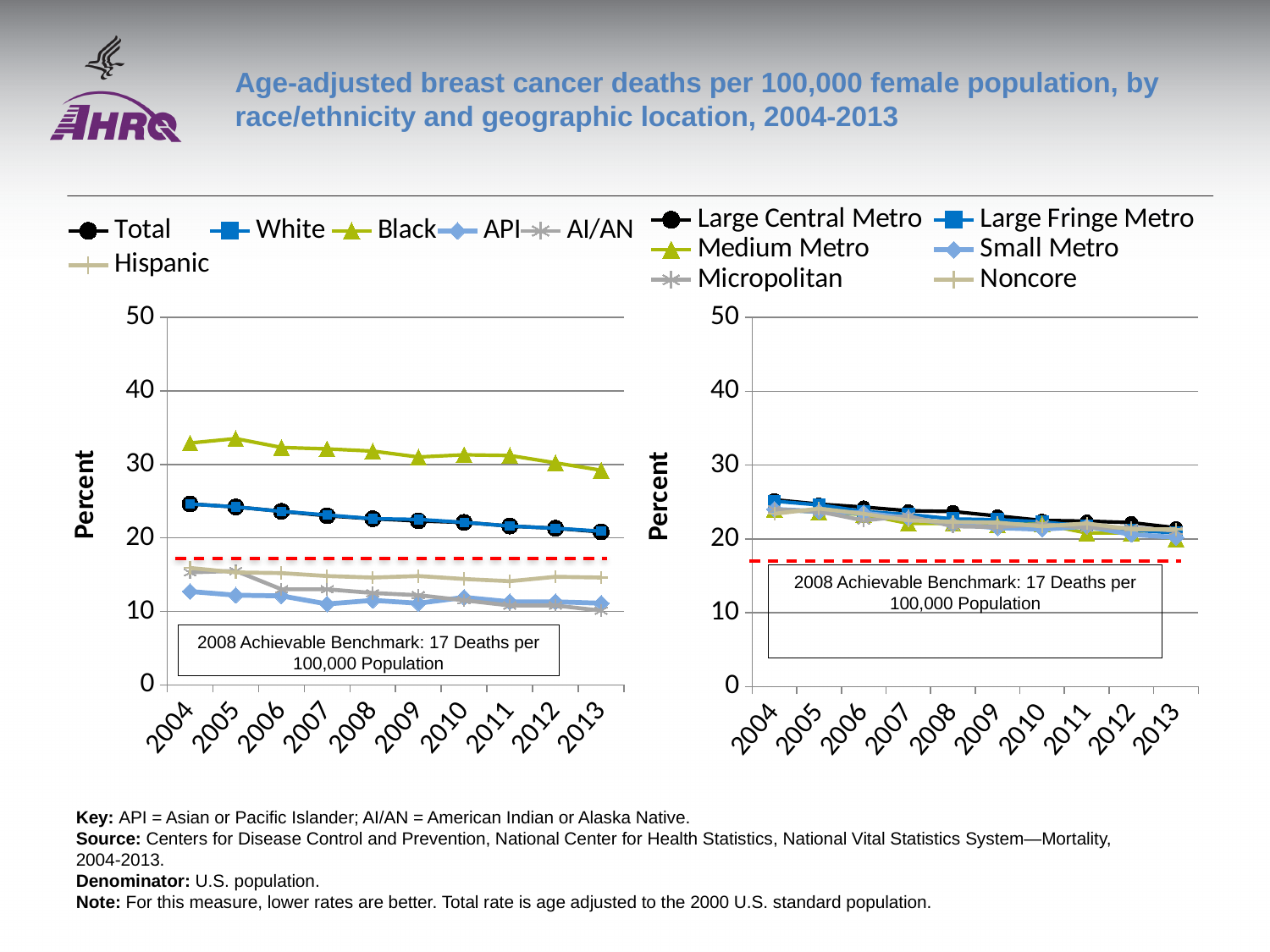
What is the 2008 Achievable Benchmark shown on the charts? 17 Deaths per 100,000 Population In the left chart (by race/ethnicity), is the value for Black in 2004 greater or less than 30? greater How many years are shown on the x axis of the left chart (by race/ethnicity)? 10 In the left chart (by race/ethnicity), is the value for API in 2004 greater or less than 20? less How many series does the legend of the left chart (by race/ethnicity) list? 6 What kind of chart is the left chart (by race/ethnicity)? line chart In the left chart (by race/ethnicity), which is larger in 2013, the value for Black or the value for Total? Black How many series does the legend of the right chart (by geographic location) list? 6 In the left chart (by race/ethnicity), do the values for Black rise or fall from 2004 to 2013? fall In the right chart (by geographic location), is the value for Large Central Metro in 2004 greater or less than 20? greater In the left chart (by race/ethnicity), which series has the highest values across all years? Black